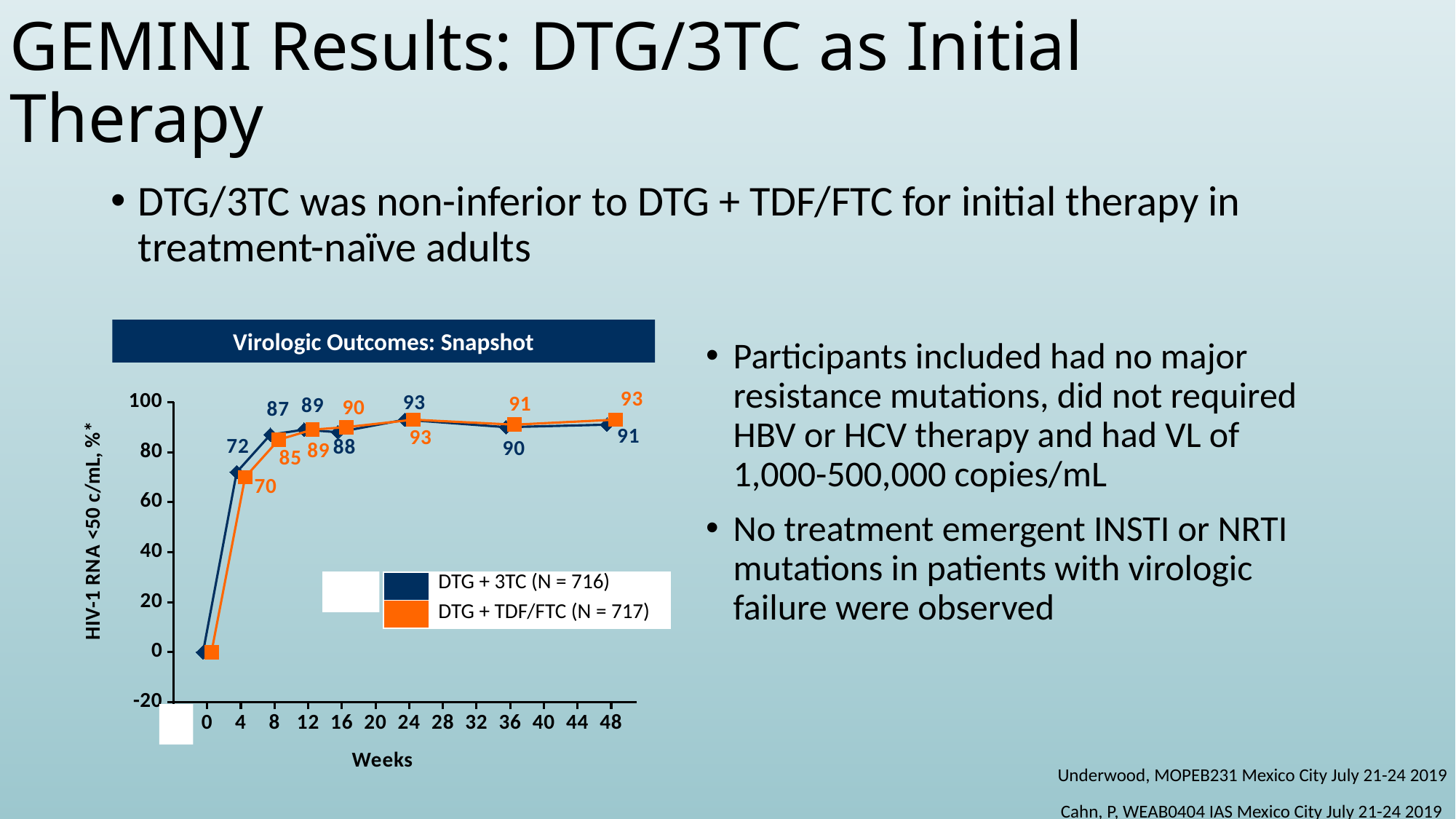
What is the value for DTG + TDF/FTC at week 4? 70 What type of chart is shown under the title "Virologic Outcomes: Snapshot"? line chart Is the value for DTG + 3TC at week 4 greater or less than 80? less What is the value for DTG + 3TC at week 4? 72 What is the difference between DTG + 3TC and DTG + TDF/FTC at week 8? 2 What is the label of the y-axis on the "Virologic Outcomes: Snapshot" chart? HIV-1 RNA <50 c/mL, %* What is the value for DTG + 3TC at week 48? 91 What is the value for DTG + TDF/FTC at week 48? 93 At week 16, which series has the larger value, DTG + 3TC or DTG + TDF/FTC? DTG + TDF/FTC Does the DTG + TDF/FTC series rise or fall between week 0 and week 8? rise How many series does the legend of the "Virologic Outcomes: Snapshot" chart list? 2 At which week does the DTG + 3TC series reach its highest labelled value? 24